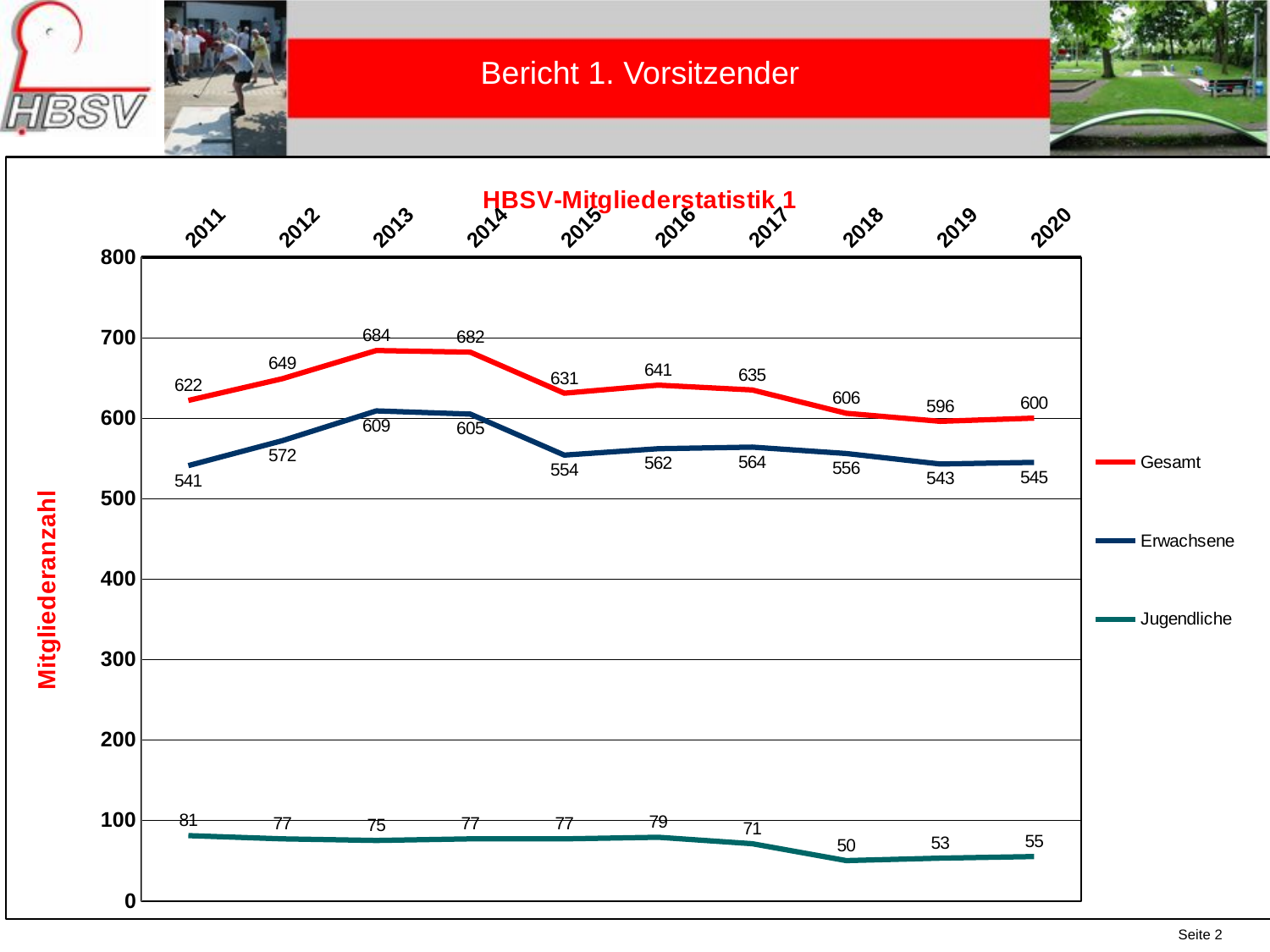
In which year is the Gesamt series highest? 2013 What is the Erwachsene value for 2011? 541 What is the Jugendliche value for 2018? 50 Which is larger, the Erwachsene value for 2012 or for 2014? 2014 How many series does the legend list? 3 How many years are shown on the x axis? 10 What is the title of the chart? HBSV-Mitgliederstatistik 1 In which year is the Jugendliche series lowest? 2018 What kind of chart is shown on the slide? line chart What is the difference between the Gesamt values for 2013 and 2019? 88 What is the Gesamt value for 2013? 684 Does the Gesamt series rise or fall from 2017 to 2019? fall